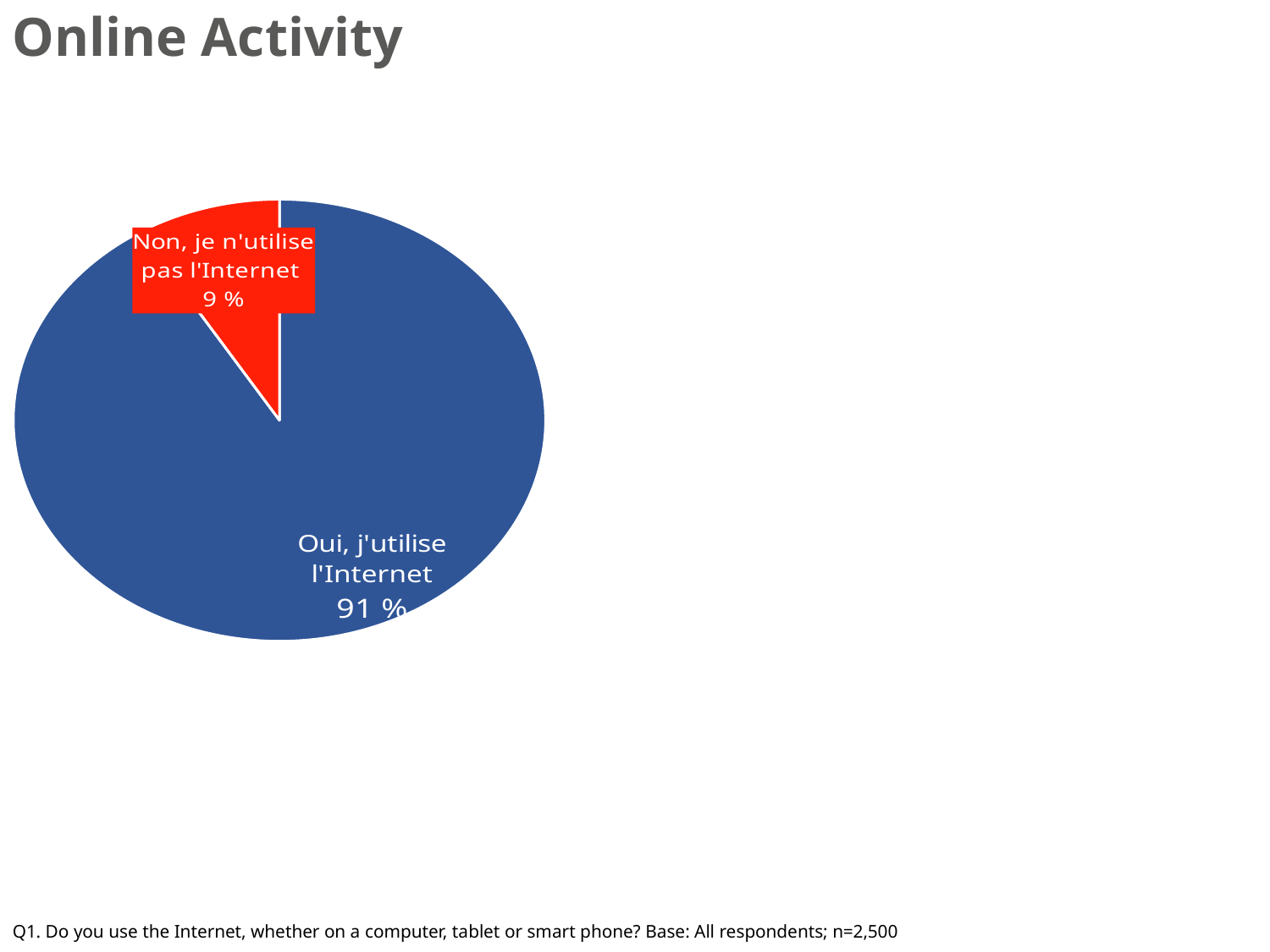
What is the title of the slide containing the pie chart? Online Activity Which is larger: the "Oui, j'utilise l'Internet" slice or the "Non, je n'utilise pas l'Internet" slice? Oui, j'utilise l'Internet Which slice of the pie is the smallest? Non, je n'utilise pas l'Internet What share of the pie is labelled "Oui, j'utilise l'Internet"? 91 % What is the total of the two slice percentages shown on the pie chart? 100 % What is the difference in percentage points between the "Oui, j'utilise l'Internet" slice and the "Non, je n'utilise pas l'Internet" slice? 82 percentage points What colour is the "Non, je n'utilise pas l'Internet" slice? red What share of the pie is labelled "Non, je n'utilise pas l'Internet"? 9 % What kind of chart is shown on the slide? pie chart Which slice of the pie is the largest? Oui, j'utilise l'Internet How many slices does the pie chart have? 2